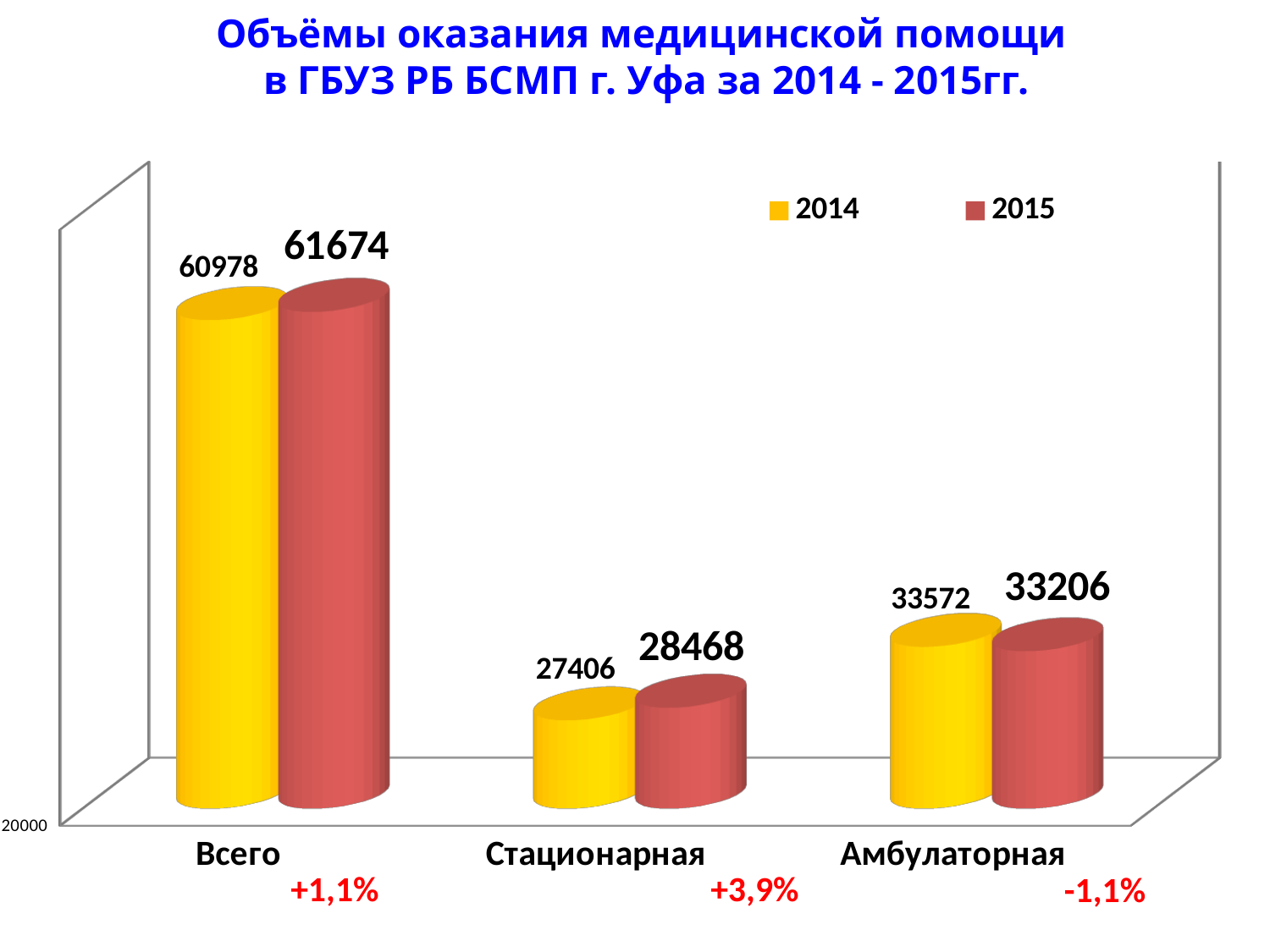
Which category has the lowest value in 2014? Стационарная How many categories are shown on the x axis? 3 What is the value for Стационарная in 2014? 27406 What is the value for Амбулаторная in 2015? 33206 What is the value for Всего in 2015? 61674 How many series does the legend list? 2 What is the value for Всего in 2014? 60978 What kind of chart is shown on the slide? Bar chart Which category has the highest value in 2015? Всего What is the difference between the 2015 and 2014 values for Стационарная? 1062 What is the value for Стационарная in 2015? 28468 Which is larger for Амбулаторная: the 2014 value or the 2015 value? 2014